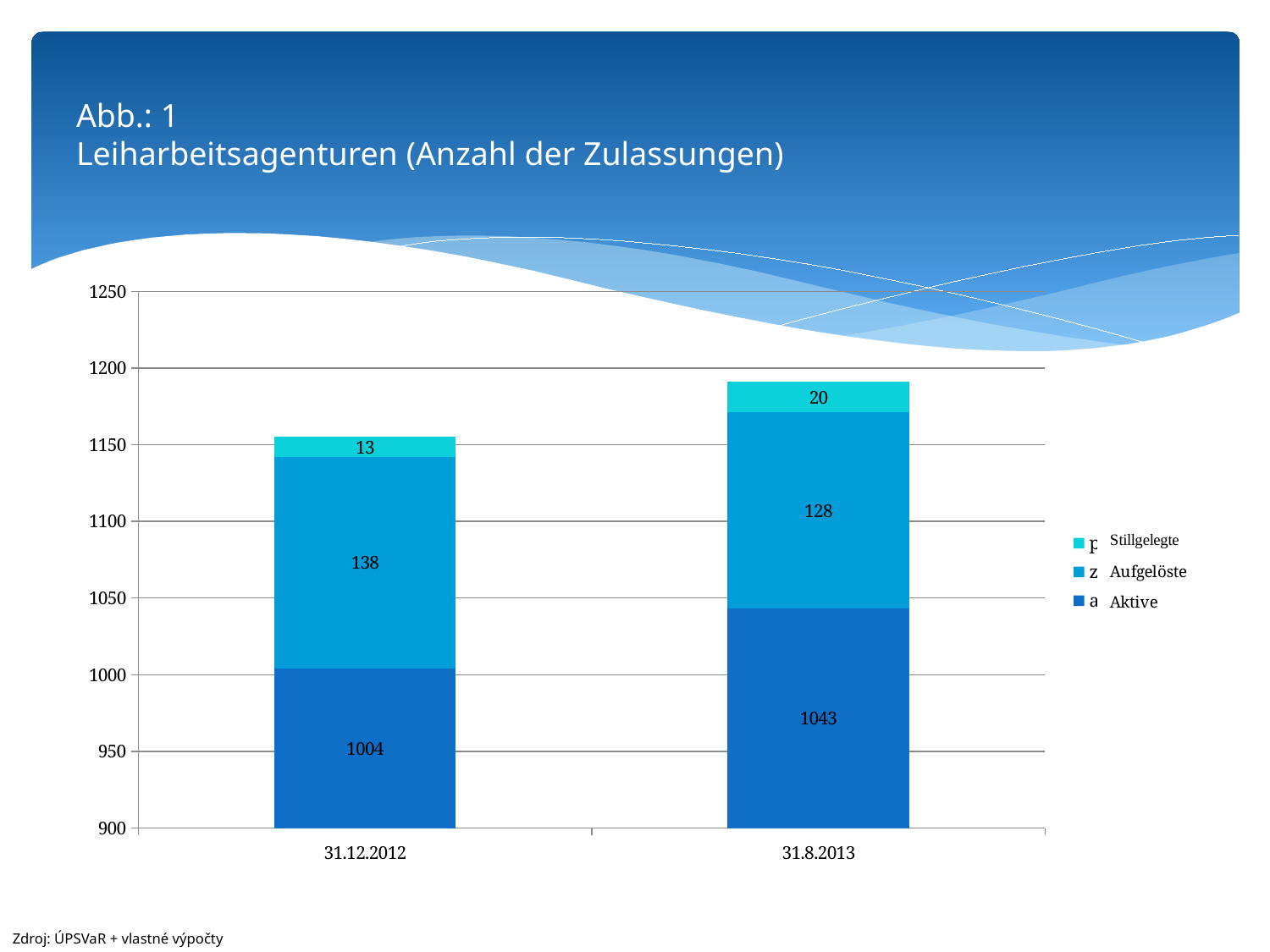
What is the total of the stacked bar for 31.8.2013? 1191 How many categories are shown on the x axis? 2 What is the value for Aktive on 31.12.2012? 1004 What type of chart is shown on the slide? stacked bar chart Does the Stillgelegte value rise or fall from 31.12.2012 to 31.8.2013? rise What is the value for Aktive on 31.8.2013? 1043 What is the value for Aufgelöste on 31.8.2013? 128 Which date has the larger Aufgelöste value, 31.12.2012 or 31.8.2013? 31.12.2012 How many series does the legend list? 3 What is the difference between the Aktive values for 31.8.2013 and 31.12.2012? 39 What is the total of the stacked bar for 31.12.2012? 1155 What is the value for Stillgelegte on 31.12.2012? 13